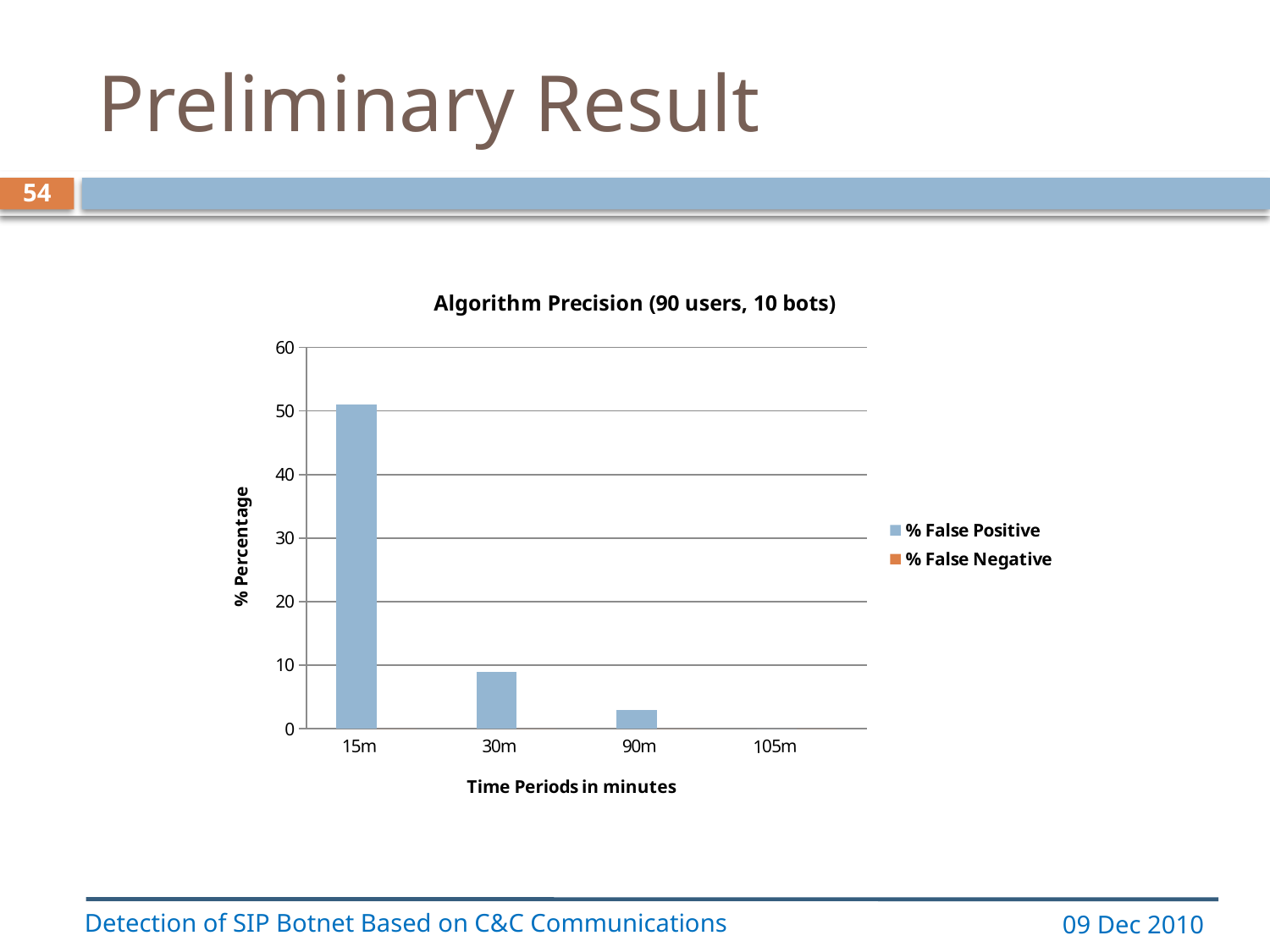
Is the % False Positive value for 90m greater or less than 10? less What is the label of the x axis? Time Periods in minutes Is the % False Positive value for 30m greater or less than 20? less Which has a larger % False Positive value, 30m or 90m? 30m Is the % False Positive value for 15m greater or less than 40? greater What type of chart is shown on the slide? bar chart How many time period categories are shown on the x axis? 4 How many series does the legend list? 2 Which time period has the highest % False Positive value? 15m Do the % False Positive values rise or fall as the time period increases from 15m to 90m? fall What is the title of the chart? Algorithm Precision (90 users, 10 bots) Among 15m, 30m and 90m, which time period has the lowest % False Positive value? 90m